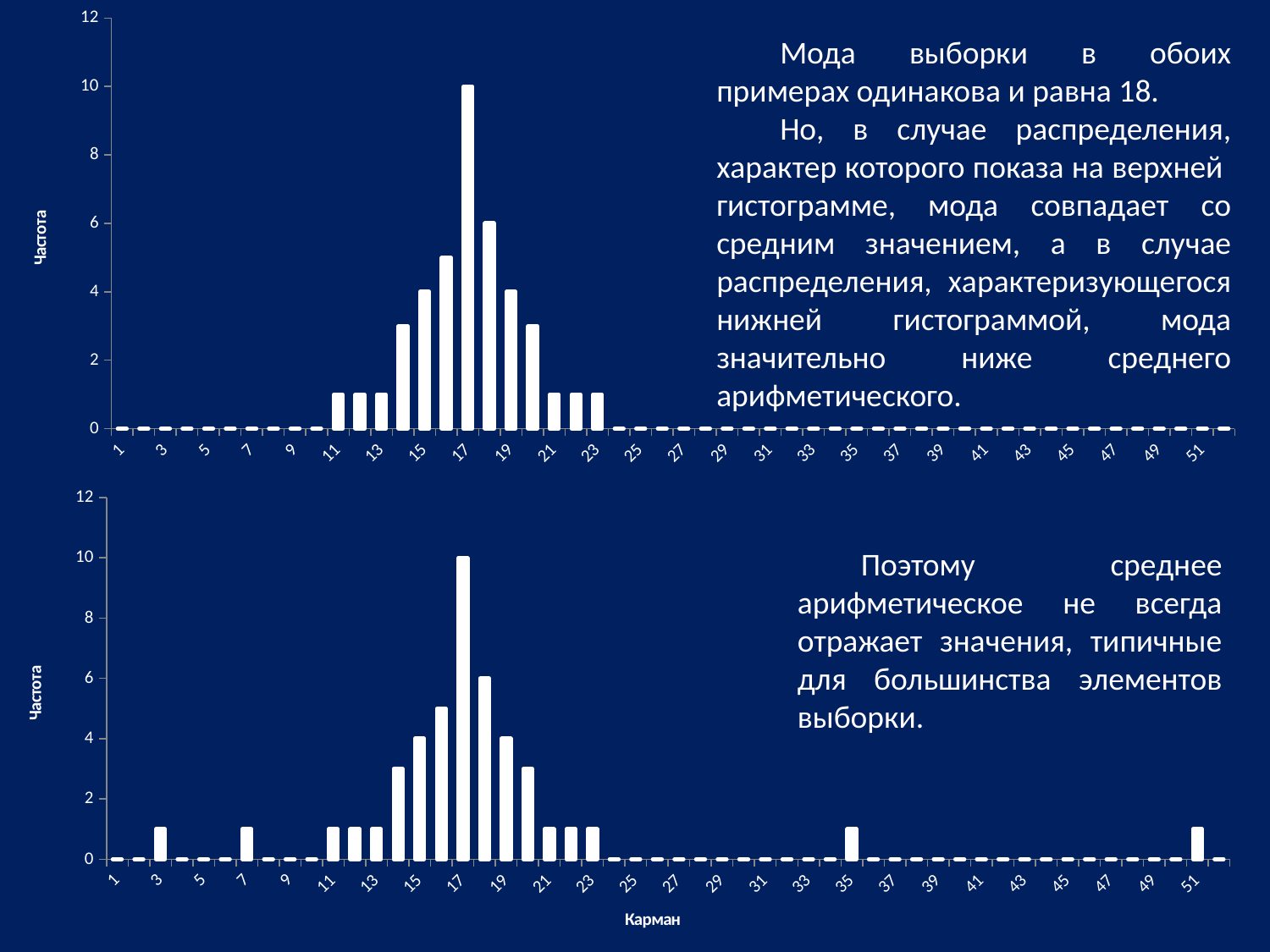
In the bottom chart, is the value for bin 35 greater or less than 2? less What is the title of the vertical axis on the top chart? Частота What is the highest tick value shown on the vertical axis of the top chart? 12 In the bottom chart, how many bars have a non-zero height? 17 In the bottom chart, which is larger: the value for bin 3 or the value of the tallest bar near the centre? the tallest bar near the centre In the bottom chart, what is the value of the tallest bar? 10 What is the title of the horizontal axis on the bottom chart? Карман In the bottom chart, is the value for bin 51 greater or less than 2? less What kind of chart is the top chart on the slide? bar chart In the top chart, what is the value of the tallest bar? 10 What kind of chart is the bottom chart on the slide? bar chart In the top chart, is the value of the tallest bar greater or less than 8? greater